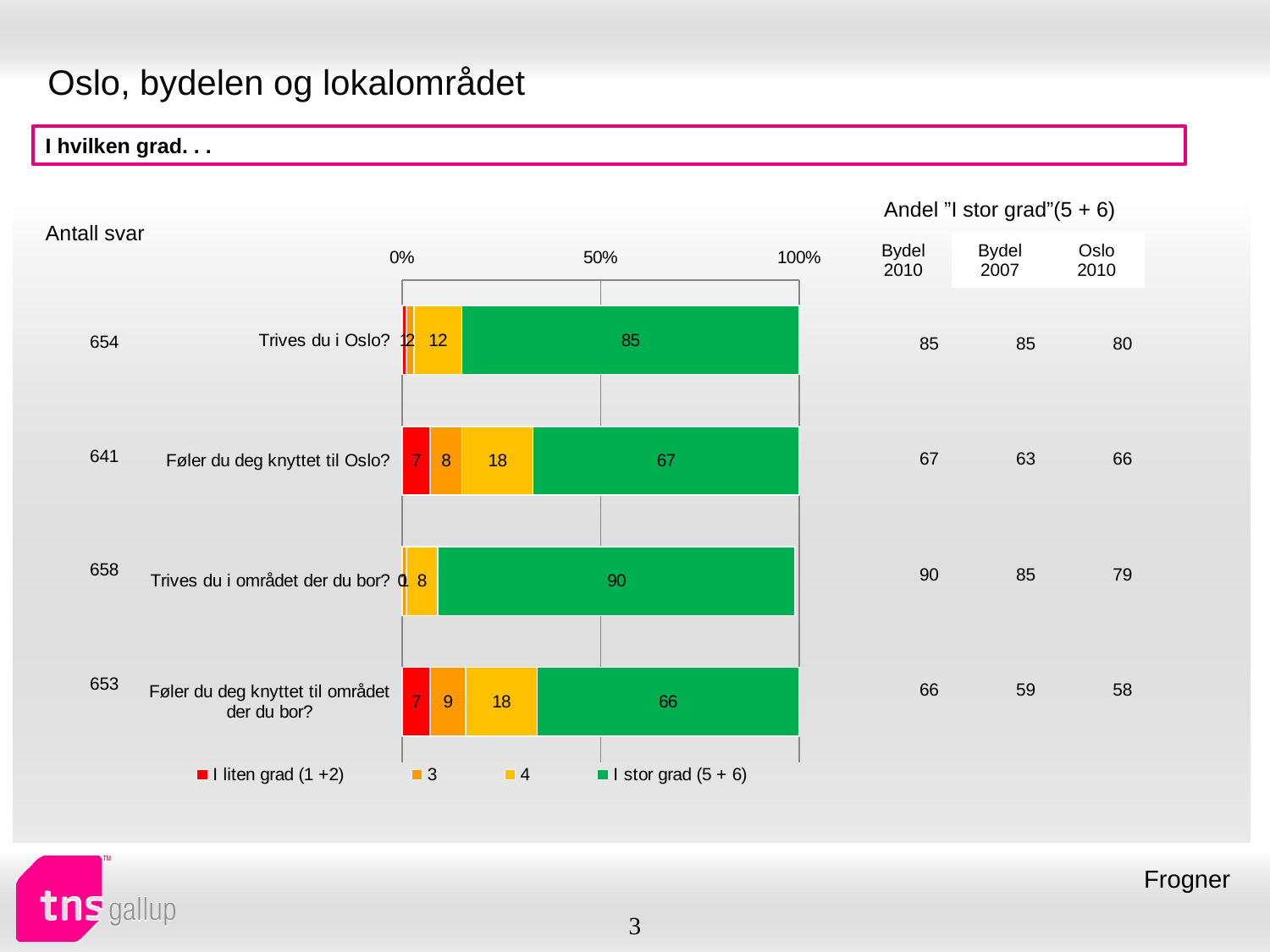
How many question categories are plotted in the chart? 4 How many series does the chart legend list? 4 What is the value of 'I stor grad (5 + 6)' for 'Trives du i Oslo?'? 85 What is the 'Antall svar' (number of responses) shown for 'Trives du i området der du bor?'? 658 What is the value of 'I stor grad (5 + 6)' for 'Trives du i området der du bor?'? 90 Which category has the lowest 'I stor grad (5 + 6)' value? Føler du deg knyttet til området der du bor? What type of chart is shown on the slide? stacked bar chart Which category has the highest 'I stor grad (5 + 6)' value? Trives du i området der du bor? What is the value of series '4' for 'Føler du deg knyttet til Oslo?'? 18 What is the value of series '3' for 'Føler du deg knyttet til området der du bor?'? 9 Is the 'I stor grad (5 + 6)' value for 'Føler du deg knyttet til Oslo?' greater or less than 50%? greater What is the difference between the 'I stor grad (5 + 6)' values for 'Trives du i området der du bor?' and 'Føler du deg knyttet til Oslo?'? 23